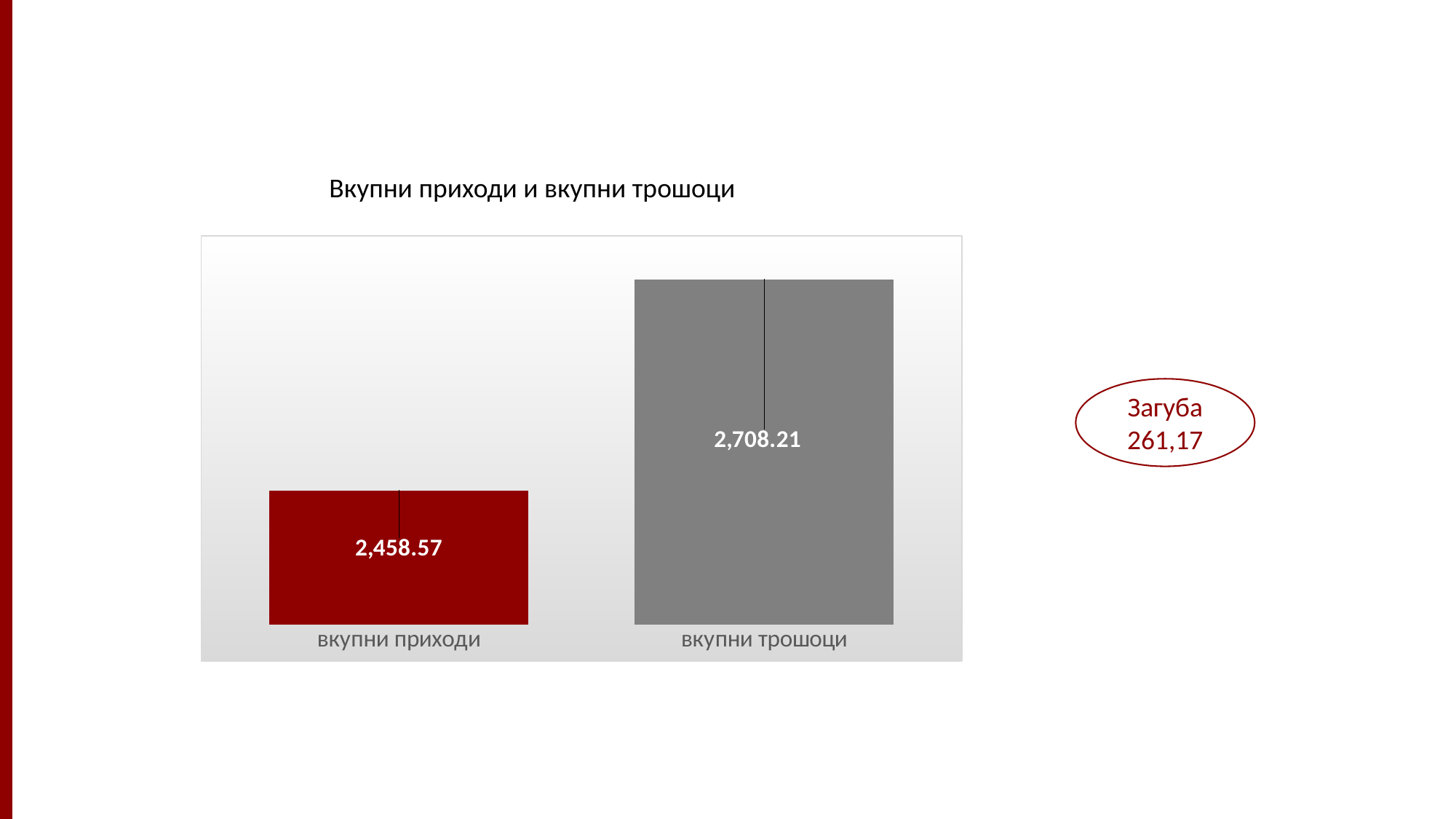
What is the title of the chart? Вкупни приходи и вкупни трошоци Which category has the lowest value? вкупни приходи How many categories are shown in the chart? 2 Which is larger, вкупни приходи or вкупни трошоци? вкупни трошоци What is the value for вкупни трошоци? 2,708.21 Which category has the highest value? вкупни трошоци What kind of chart is shown on the slide? bar chart What is the difference between вкупни трошоци and вкупни приходи? 249.64 What colour is the bar for вкупни приходи? dark red What is the value for вкупни приходи? 2,458.57